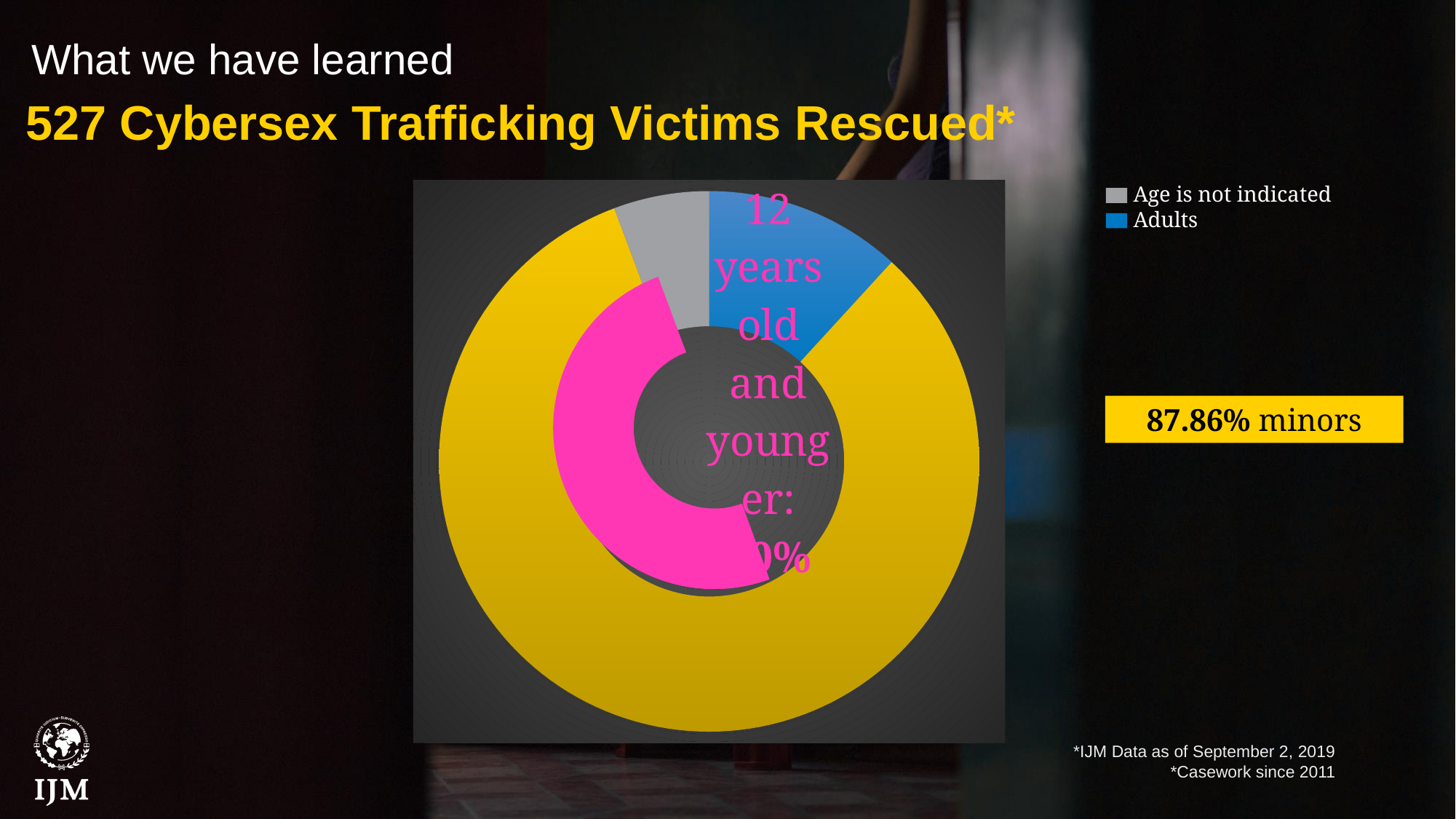
What colour represents Adults in the pie chart? blue How many slices make up the outer ring of the pie chart? 3 Which slice is larger: Adults or Age is not indicated? Adults How many entries does the chart legend list? 2 Which legend category has the smallest slice of the pie chart? Age is not indicated Is the share for Adults greater or less than 50%? less What percentage of the rescued victims were minors, according to the slide? 87.86% Which group accounts for the largest slice of the pie chart? minors What kind of chart is shown on the slide? doughnut chart What colour is the largest slice of the pie chart? yellow